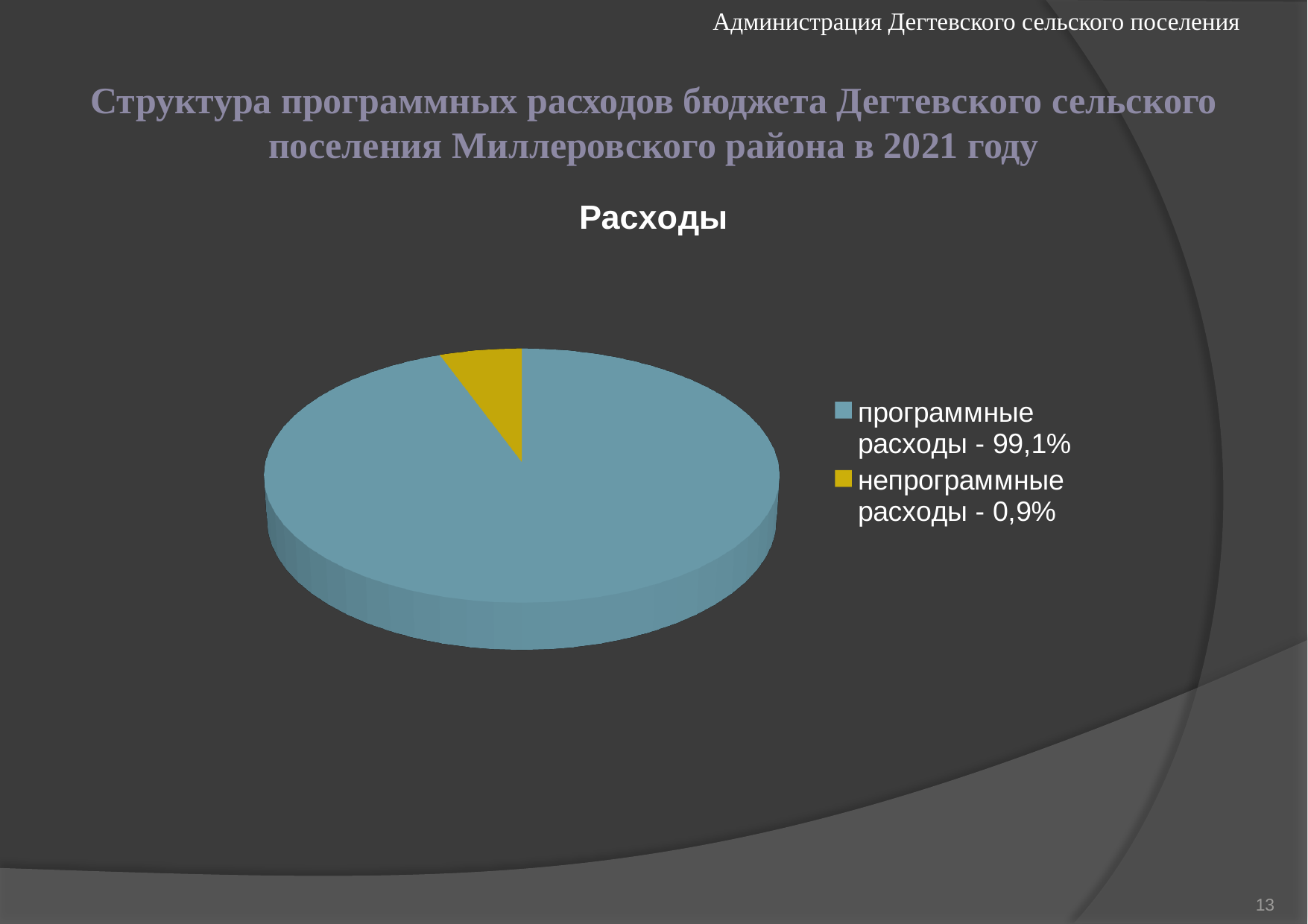
What is the title of the chart? Расходы What colour is the slice for 'непрограммные расходы'? yellow What is the difference in percentage points between 'программные расходы' and 'непрограммные расходы'? 98,2 Which is larger, 'программные расходы' or 'непрограммные расходы'? программные расходы What share of the pie is 'программные расходы'? 99,1% What share of the pie is 'непрограммные расходы'? 0,9% How many slices does the pie chart have? 2 How many entries does the legend list? 2 Which slice is the largest? программные расходы Which slice is the smallest? непрограммные расходы What kind of chart is shown on the slide? pie chart